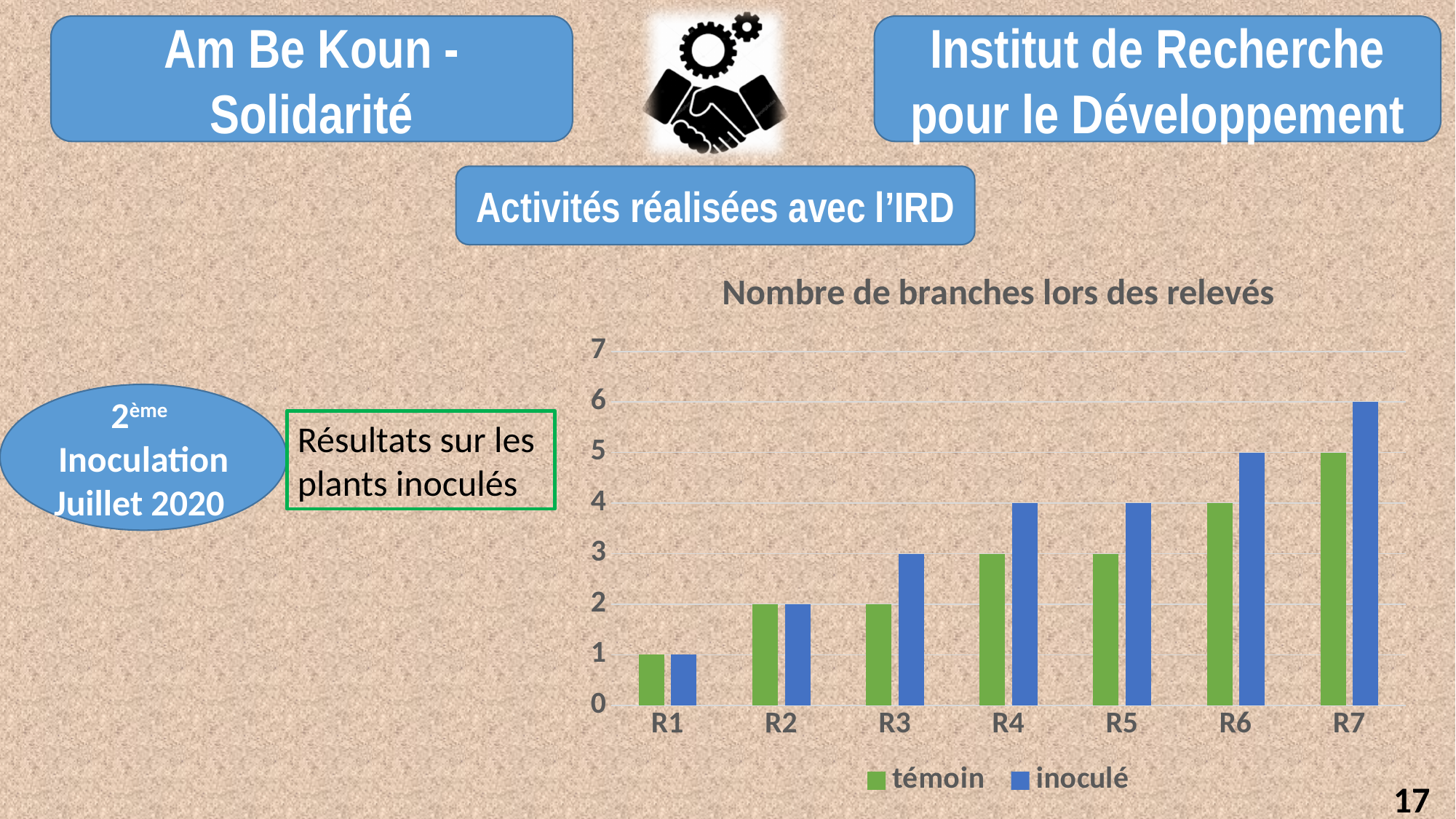
Do the témoin values rise or fall from R1 to R7? rise What is the difference between inoculé and témoin at R6? 1 Which category has the highest value for the inoculé series? R7 What is the value for inoculé at R7? 6 Which category has the lowest value for the témoin series? R1 What is the value for témoin at R4? 3 How many series does the chart legend list? 2 How many categories are shown on the x axis of the chart? 7 What is the value for inoculé at R3? 3 At R5, which series has the larger value, témoin or inoculé? inoculé What is the title of the chart? Nombre de branches lors des relevés What kind of chart is shown on the slide? bar chart